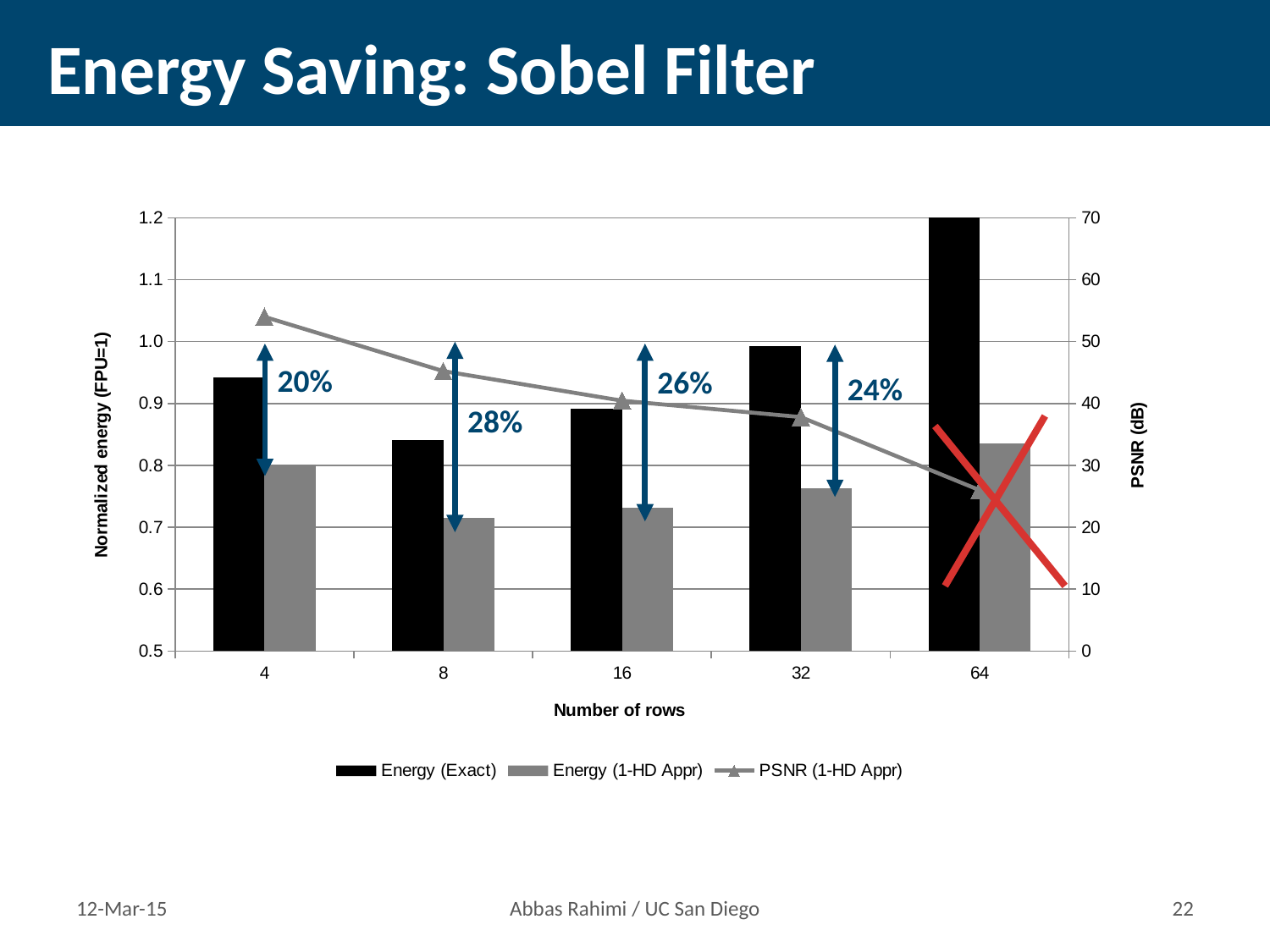
Which number of rows has the highest Energy (Exact) value? 64 What energy saving percentage is annotated for 4 rows? 20% Which number of rows has the highest annotated energy saving percentage? 8 Which is larger at 16 rows, Energy (Exact) or Energy (1-HD Appr)? Energy (Exact) What energy saving percentage is annotated for 8 rows? 28% Does the PSNR (1-HD Appr) line rise or fall as the number of rows increases? falls How many categories are shown on the x axis (Number of rows)? 5 What energy saving percentage is annotated for 16 rows? 26% What kind of chart is shown on the slide? a combined bar and line chart How many series does the legend list? 3 Is the Energy (Exact) value for 32 rows greater or less than 0.9? greater What energy saving percentage is annotated for 32 rows? 24%